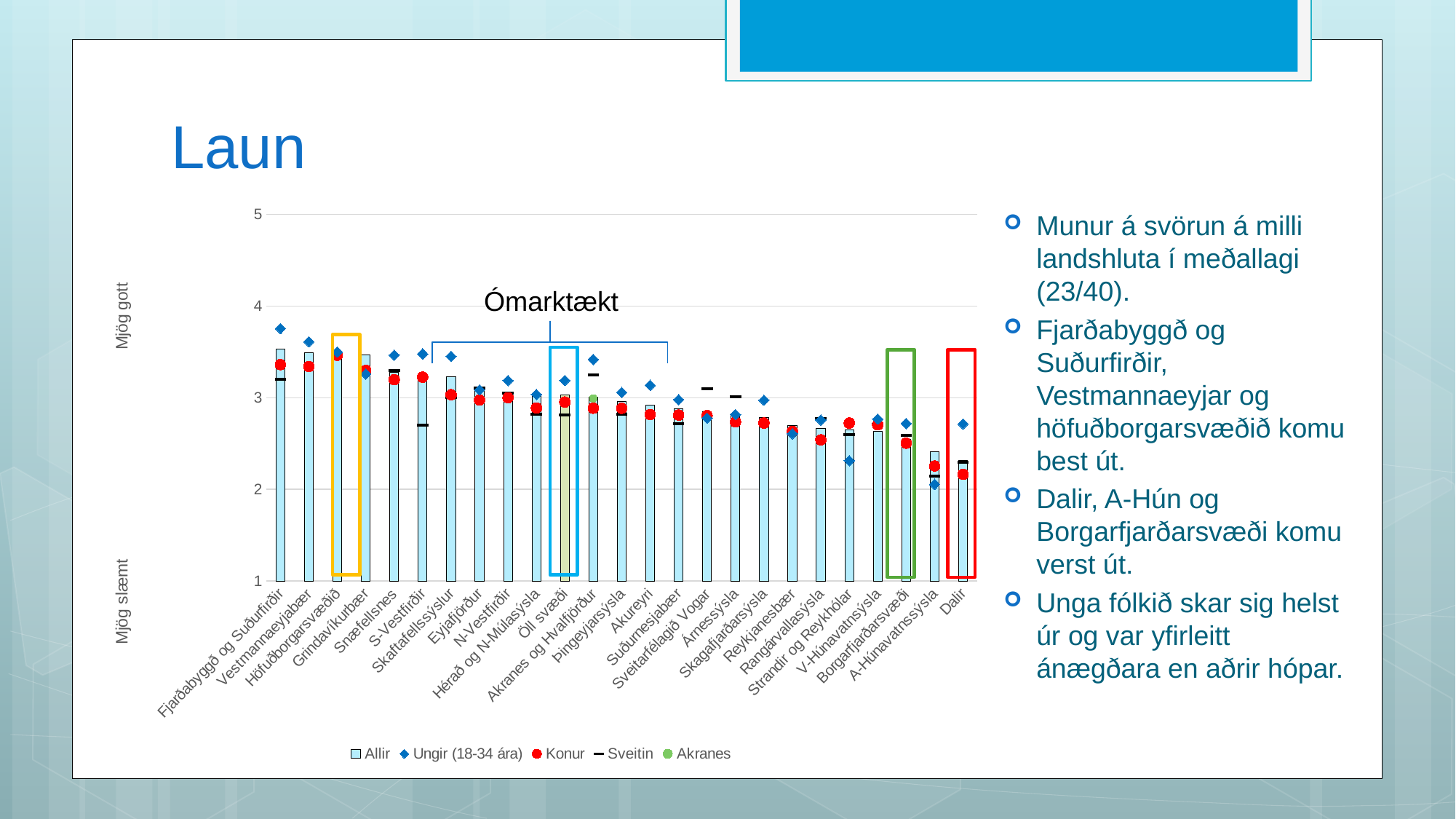
Is the Allir value for A-Húnavatnssýsla greater or less than 3? less Which has the larger Allir value, Höfuðborgarsvæðið or Dalir? Höfuðborgarsvæðið What kind of chart is shown on the slide? bar chart How many series does the legend list? 5 Which category has the lowest Allir bar? Dalir Which series is shown with red circle markers in the legend? Konur What is the title of the slide containing the chart? Laun Is the Allir value for Dalir greater or less than 3? less Is the Ungir (18-34 ára) value for Dalir greater or less than 3? less Do the Allir bars generally rise or fall from left to right along the x axis? fall How many categories are shown on the x axis? 25